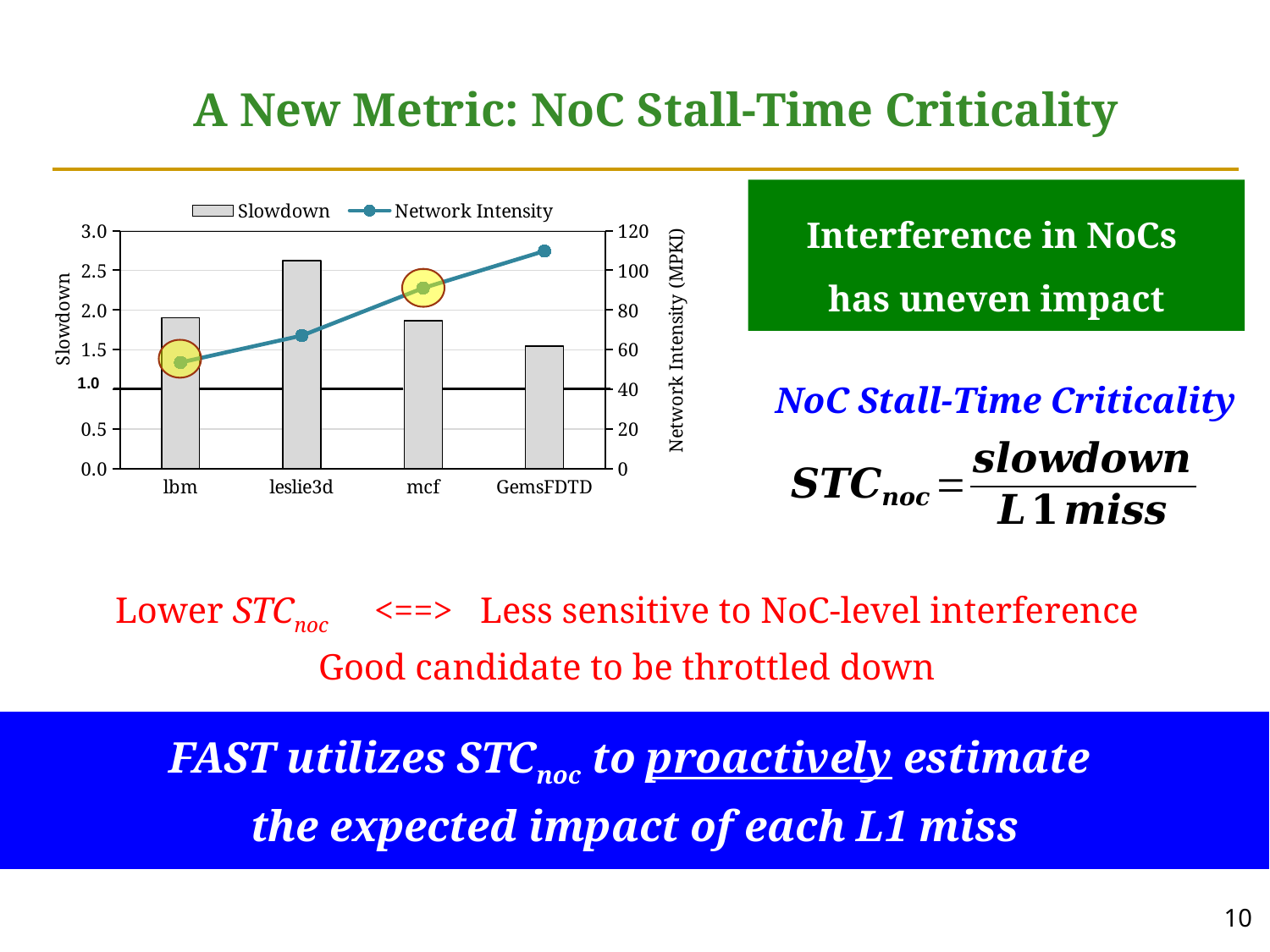
Is the Slowdown value for leslie3d greater or less than 2.5? greater Is the Network Intensity value for mcf greater or less than 80? greater Is the Slowdown value for GemsFDTD greater or less than 2.0? less Which series is plotted as bars in the chart? Slowdown Does Network Intensity rise or fall from lbm to GemsFDTD along the x axis? rise What kind of chart is shown on the slide? bar chart with a line overlay Which category has the lowest Network Intensity? lbm How many categories are shown on the x axis of the chart? 4 Which category has the lowest Slowdown bar? GemsFDTD Which category has the highest Slowdown bar? leslie3d How many series does the chart legend list? 2 Which category has the highest Network Intensity? GemsFDTD